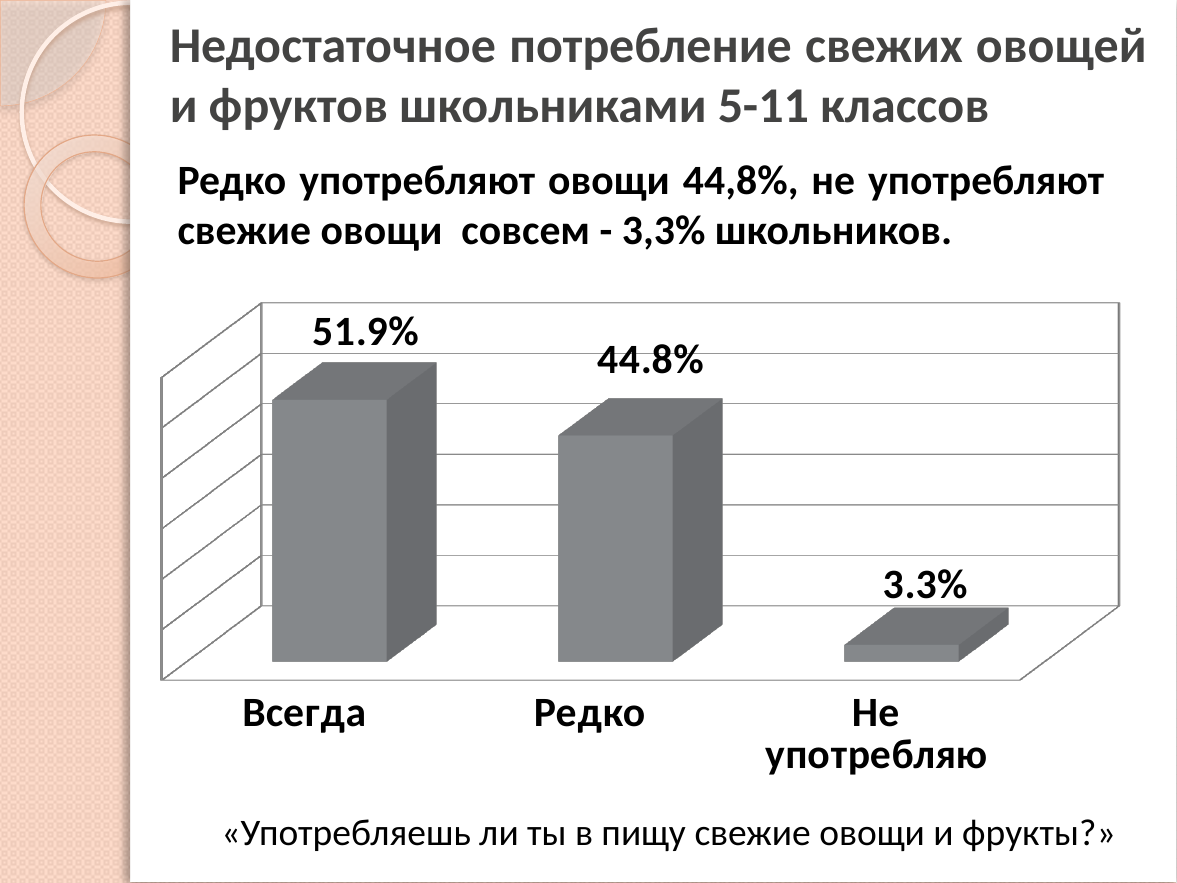
How many categories are shown in the chart? 3 Do the values rise or fall from left to right across the categories? Fall What question is quoted below the chart? «Употребляешь ли ты в пищу свежие овощи и фрукты?» Which category has the lowest value? Не употребляю What is the value for Всегда? 51.9% Which category has the highest value? Всегда What is the difference between the values for Редко and Не употребляю? 41.5% What kind of chart is shown on the slide? Bar chart Which is larger, the value for Всегда or the value for Редко? Всегда What is the value for Редко? 44.8% What is the value for Не употребляю? 3.3% What is the difference between the values for Всегда and Редко? 7.1%